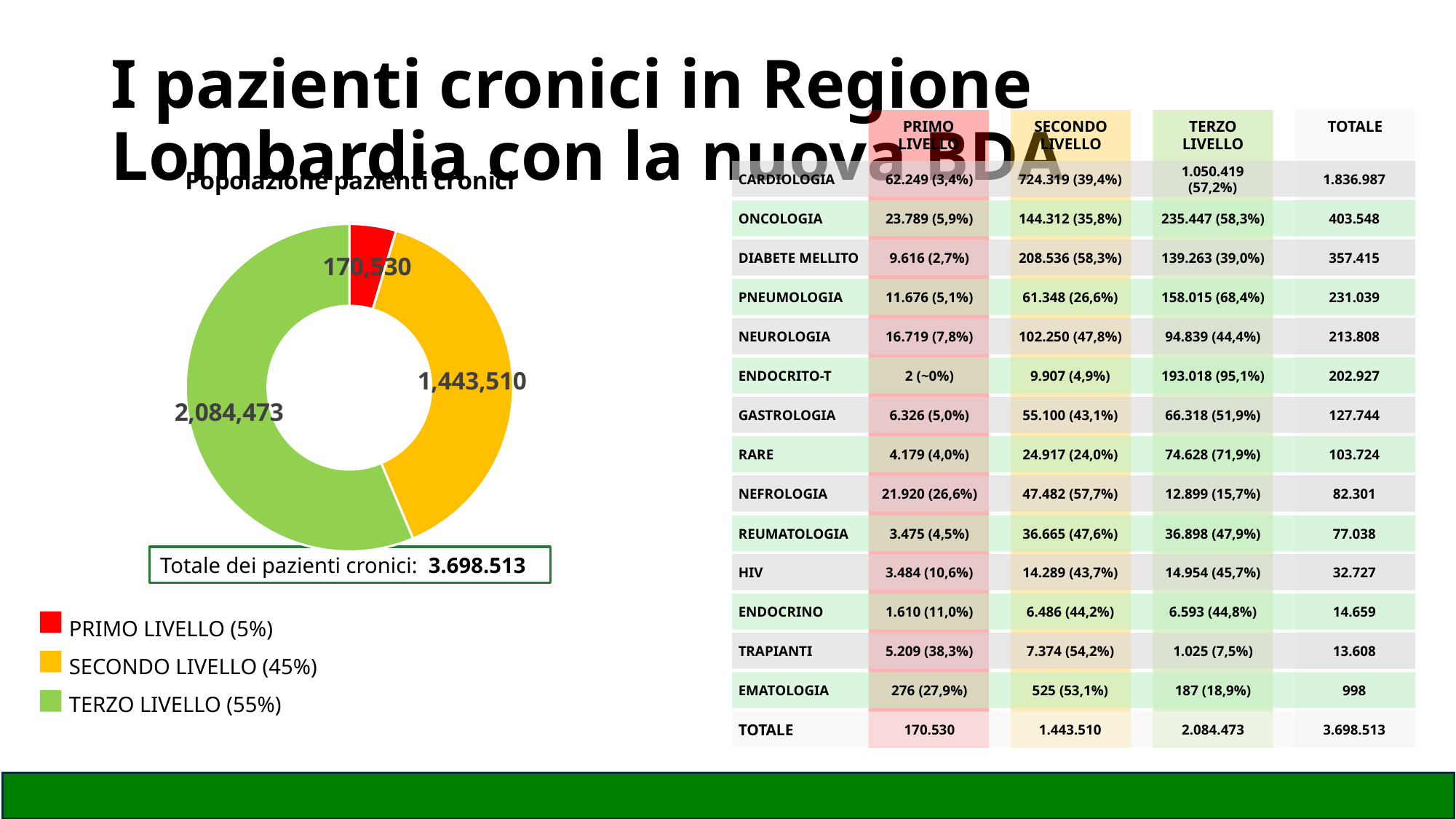
Which is larger in the chart, SECONDO LIVELLO or TERZO LIVELLO? TERZO LIVELLO What share of the chart does PRIMO LIVELLO represent, according to the legend? 5% What is the value shown for SECONDO LIVELLO in the chart? 1,443,510 What colour is used for the SECONDO LIVELLO slice in the chart? Yellow/orange Which category has the largest slice in the chart? TERZO LIVELLO How many categories does the chart's legend list? 3 What is the value shown for PRIMO LIVELLO in the chart? 170,530 What type of chart is shown on the slide? Doughnut (pie) chart What share of the chart does SECONDO LIVELLO represent, according to the legend? 45% What is the value shown for TERZO LIVELLO in the chart? 2,084,473 Which category has the smallest slice in the chart? PRIMO LIVELLO What is the difference between the TERZO LIVELLO and SECONDO LIVELLO values in the chart? 640,963